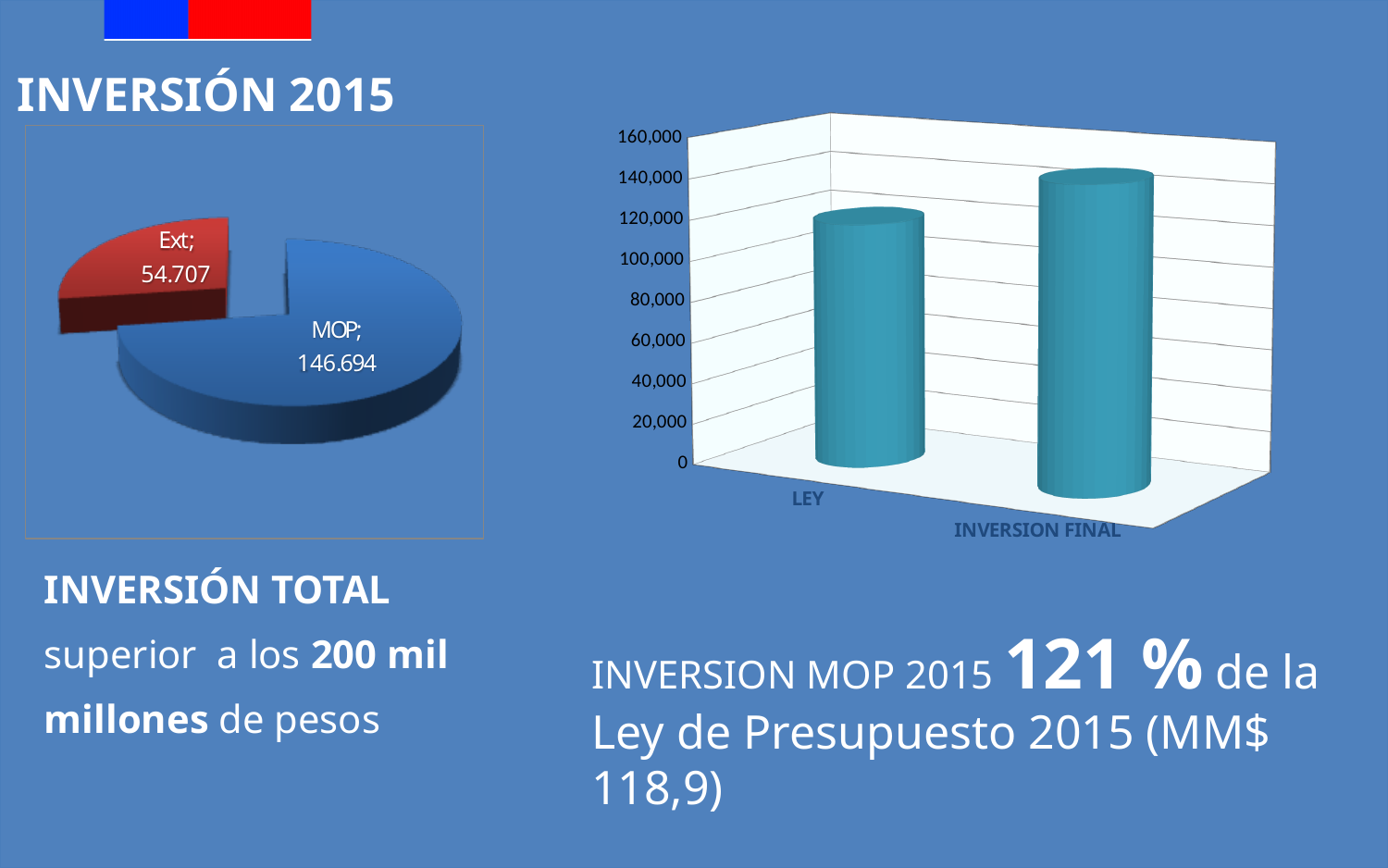
In the bar chart on the right, is the value for LEY greater or less than 100,000? greater In the bar chart on the right, how many categories are shown on the x axis? 2 What kind of chart is the chart on the left of the slide? Pie chart In the pie chart on the left, which slice is the smallest? Ext In the pie chart on the left, how many slices are there? 2 In the bar chart on the right, which category has the taller bar, LEY or INVERSION FINAL? INVERSION FINAL In the pie chart on the left, which slice is the largest? MOP In the bar chart on the right, is the value for INVERSION FINAL greater or less than 120,000? greater In the pie chart on the left, what is the value for MOP? 146.694 What kind of chart is the chart on the right of the slide? Bar chart In the pie chart on the left, what is the value for Ext? 54.707 In the pie chart on the left, what is the difference between the MOP value and the Ext value? 91.987